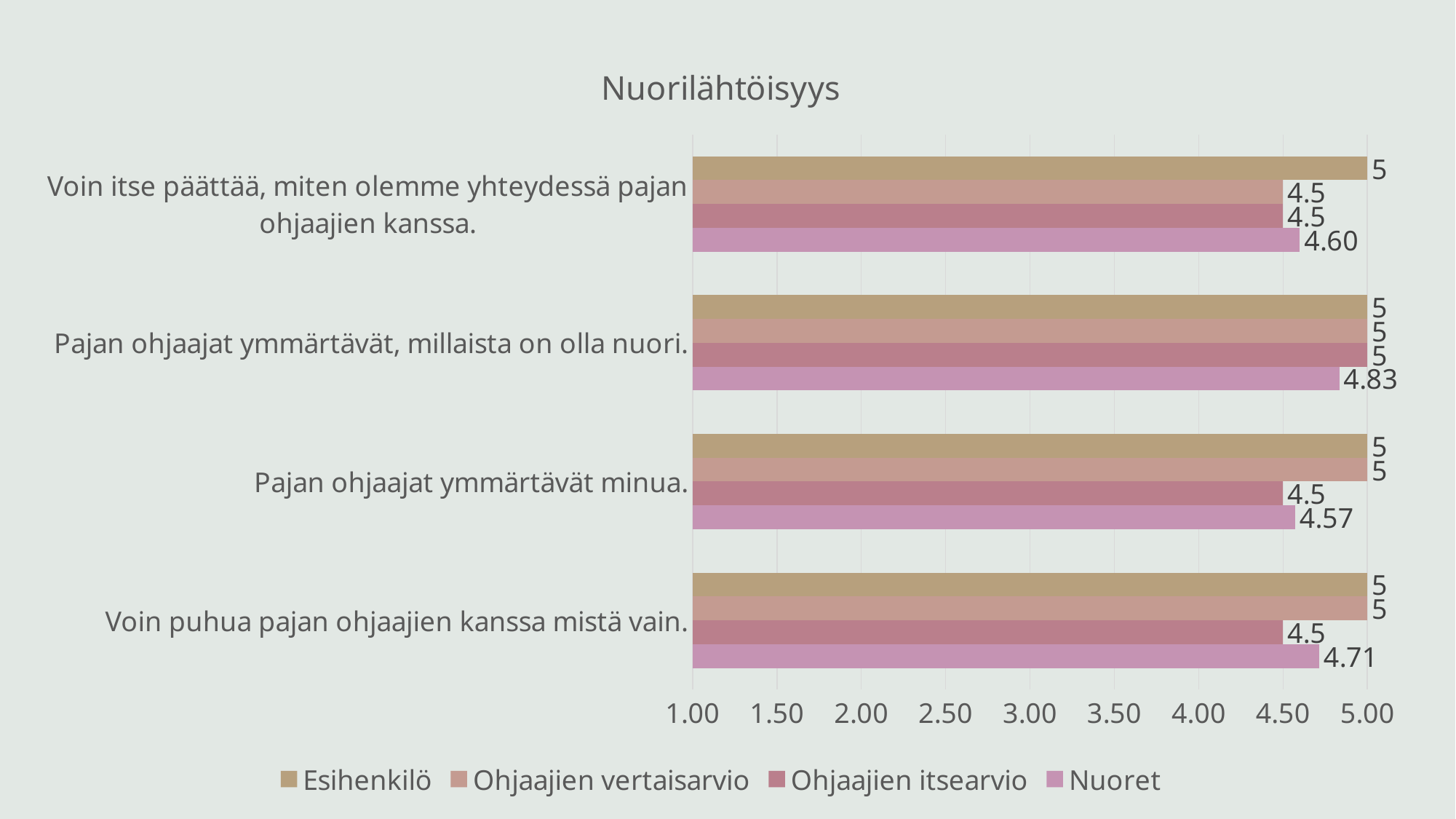
What is the Esihenkilö value for "Voin itse päättää, miten olemme yhteydessä pajan ohjaajien kanssa."? 5 How many series does the legend list? 4 How many categories are shown on the chart? 4 What is the Nuoret value for "Pajan ohjaajat ymmärtävät, millaista on olla nuori."? 4.83 What is the difference between the Esihenkilö and Nuoret values for "Voin puhua pajan ohjaajien kanssa mistä vain."? 0.29 Which category has the highest Nuoret value? Pajan ohjaajat ymmärtävät, millaista on olla nuori. What kind of chart is shown on the slide? Bar chart What is the Ohjaajien itsearvio value for "Pajan ohjaajat ymmärtävät minua."? 4.5 Which category has the lowest Nuoret value? Pajan ohjaajat ymmärtävät minua. What is the Nuoret value for "Voin puhua pajan ohjaajien kanssa mistä vain."? 4.71 For "Voin itse päättää, miten olemme yhteydessä pajan ohjaajien kanssa.", which is larger: the Nuoret value or the Ohjaajien itsearvio value? Nuoret What is the title of the chart? Nuorilähtöisyys